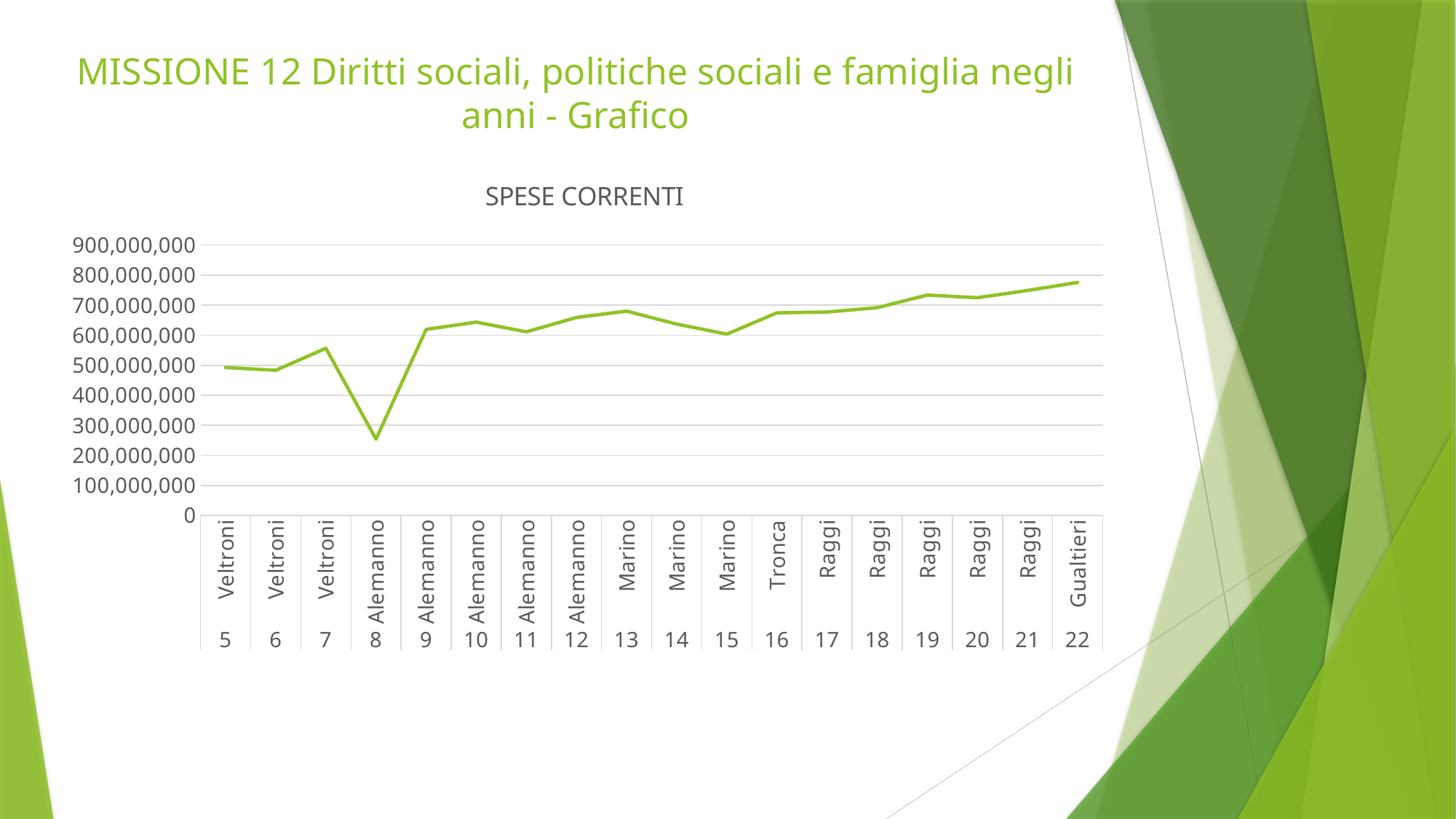
Which is larger, the value for Veltroni 7 or the value for Alemanno 8? Veltroni 7 Is the value for Gualtieri 22 greater or less than 700,000,000? greater Which is larger, the value for Marino 13 or the value for Marino 15? Marino 13 Which point on the x axis has the highest value? Gualtieri 22 What is the title of the chart? SPESE CORRENTI How many data points are plotted on the line? 18 Is the value for Veltroni 7 greater or less than 500,000,000? greater Is the value for Alemanno 8 greater or less than 300,000,000? less What kind of chart is shown on the slide? line chart Which point on the x axis has the lowest value? Alemanno 8 Do the values generally rise or fall from Tronca 16 to Gualtieri 22? rise